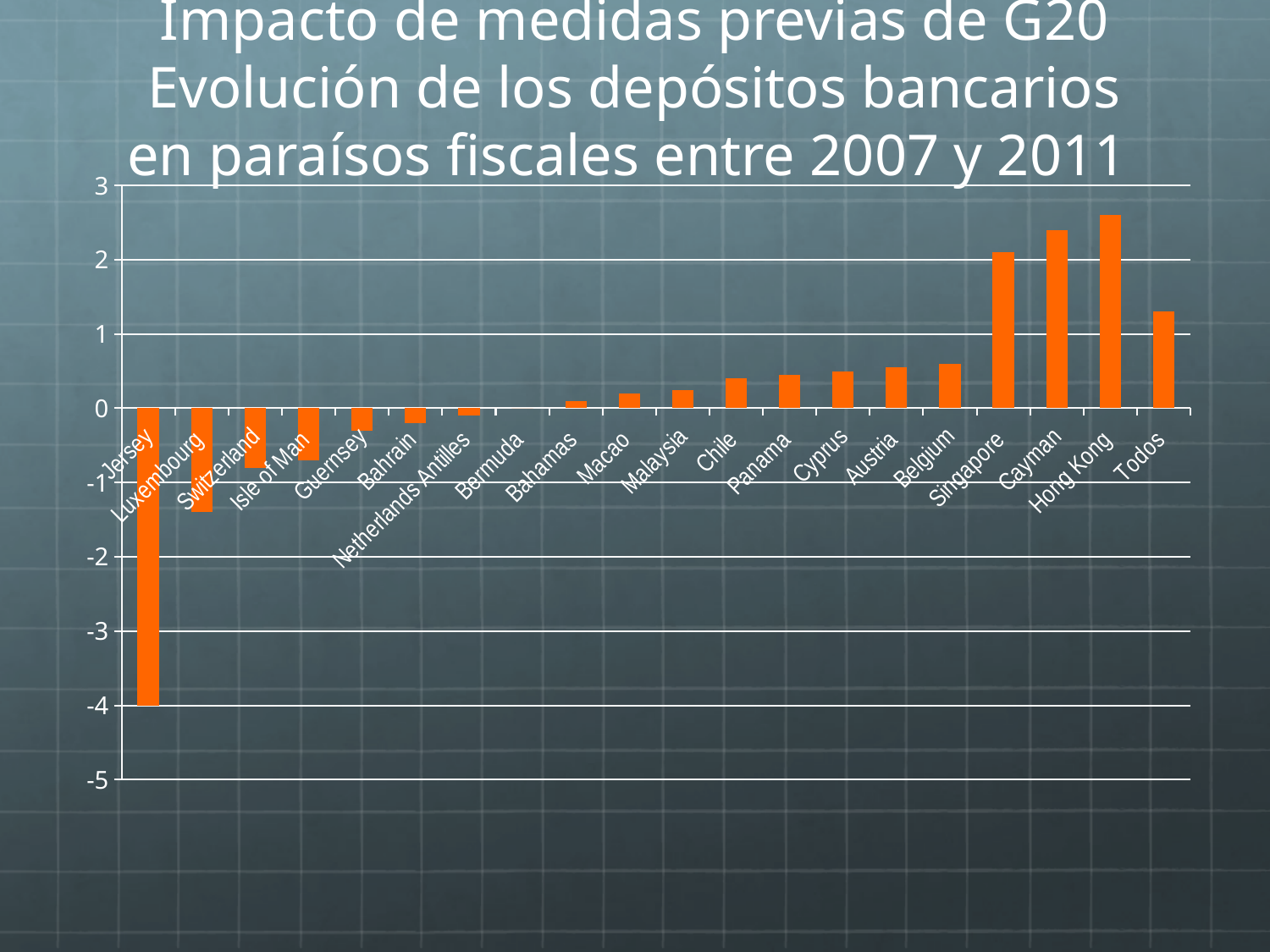
Is the value for Luxembourg greater or less than -1? less What kind of chart is shown on the slide? bar chart Is the value for Jersey greater or less than -3? less Is the value for Hong Kong greater or less than 2? greater Which category has the highest value? Hong Kong Which has the larger value, Panama or Macao? Panama How many categories are plotted on the x axis? 20 Do the values generally rise or fall along the x axis from Jersey to Hong Kong? rise Which has the larger value, Jersey or Luxembourg? Luxembourg Which category has the lowest value? Jersey Which has the larger value, Cayman or Singapore? Cayman